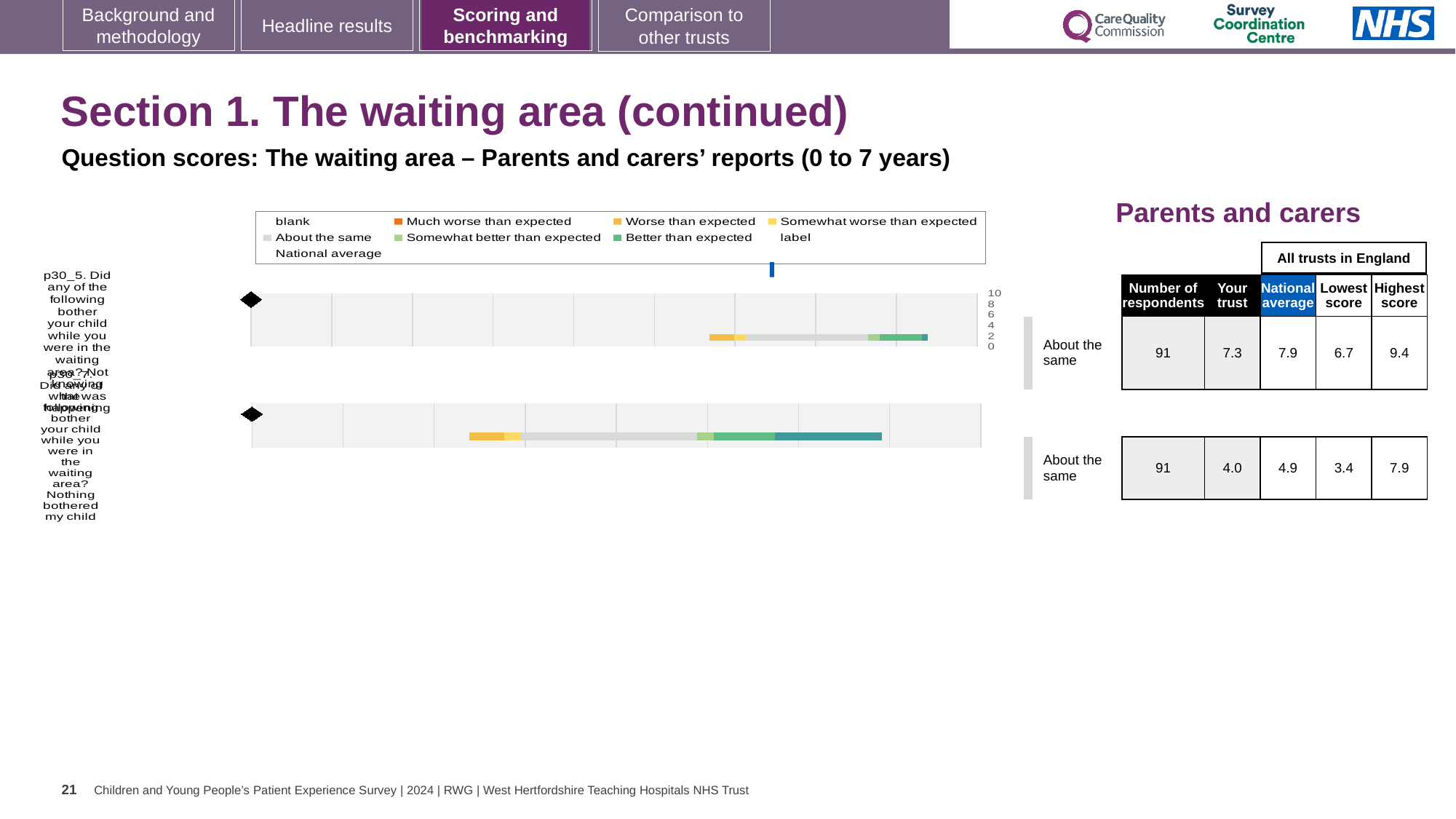
For the top chart (p30_5), what is the National average score? 7.9 How many respondents are reported for the bottom chart (p30_7)? 91 What benchmark category is shown next to the top chart (p30_5)? About the same What kind of chart is used to show the question scores on this slide? bar chart How many entries does the chart legend list? 9 For the bottom chart (p30_7), what is the score for Your trust? 4.0 For the bottom chart (p30_7), what is the Lowest score among all trusts in England? 3.4 For the top chart (p30_5), which is larger: the Your trust score or the National average? National average For the top chart (p30_5), what is the difference between the National average and the Your trust score? 0.6 For the top chart (p30_5), what is the Highest score among all trusts in England? 9.4 For the top chart (p30_5), what is the score for Your trust? 7.3 For the bottom chart (p30_7), what is the difference between the Highest score and the Lowest score? 4.5